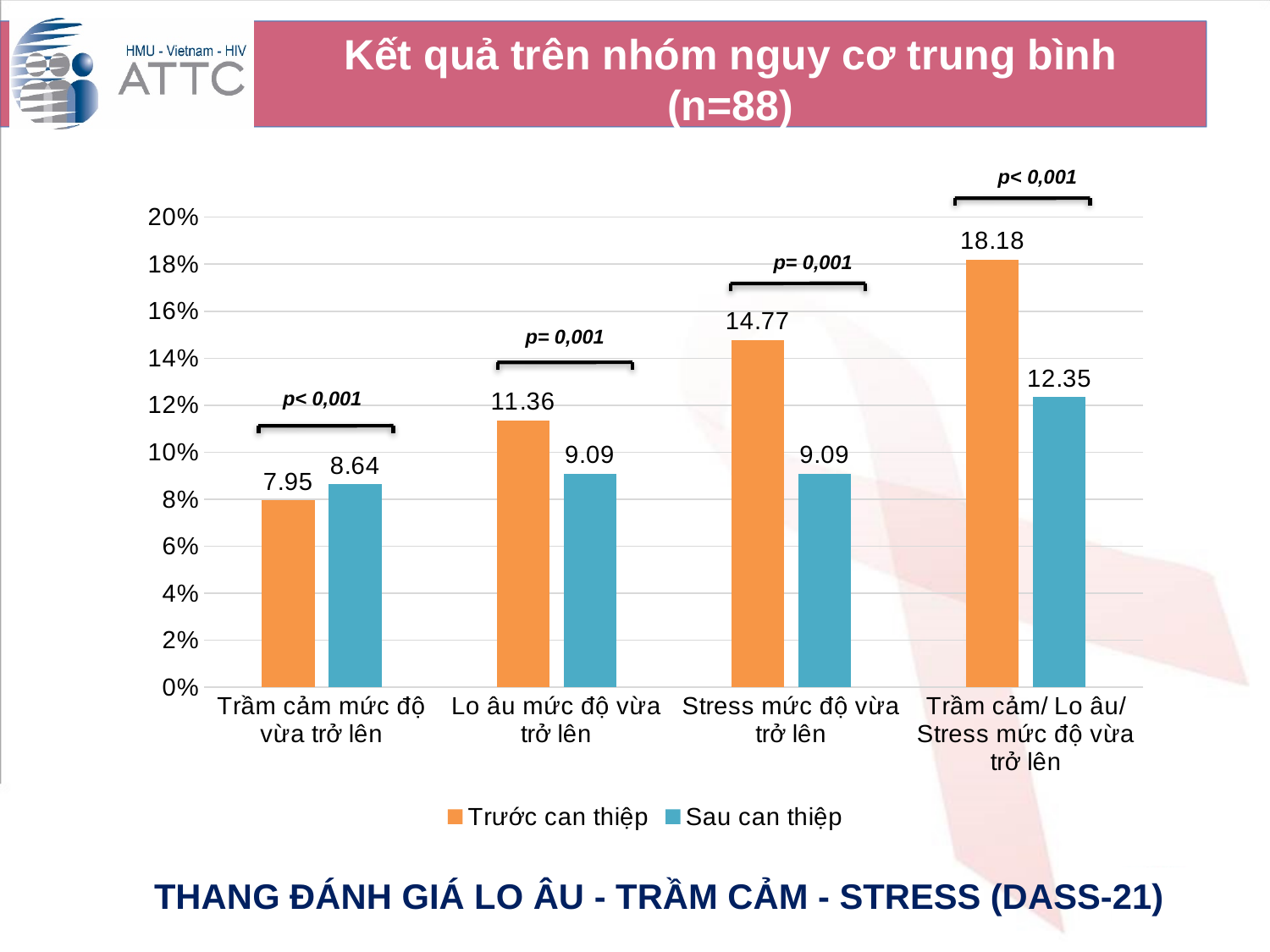
What is the value for "Trước can thiệp" in the category "Trầm cảm mức độ vừa trở lên"? 7.95 Is the "Trước can thiệp" value for "Lo âu mức độ vừa trở lên" greater or less than 10%? greater What is the value for "Sau can thiệp" in the category "Stress mức độ vừa trở lên"? 9.09 What is the difference between the "Trước can thiệp" and "Sau can thiệp" values for "Stress mức độ vừa trở lên"? 5.68 How many categories are shown on the x axis? 4 What is the value for "Sau can thiệp" in the category "Trầm cảm/ Lo âu/ Stress mức độ vừa trở lên"? 12.35 Which category has the highest "Trước can thiệp" value? Trầm cảm/ Lo âu/ Stress mức độ vừa trở lên For "Trầm cảm mức độ vừa trở lên", which is larger: "Trước can thiệp" or "Sau can thiệp"? Sau can thiệp How many series does the legend list? 2 What kind of chart is shown on the slide? bar chart Which category has the lowest "Trước can thiệp" value? Trầm cảm mức độ vừa trở lên What are the two series named in the legend? Trước can thiệp and Sau can thiệp